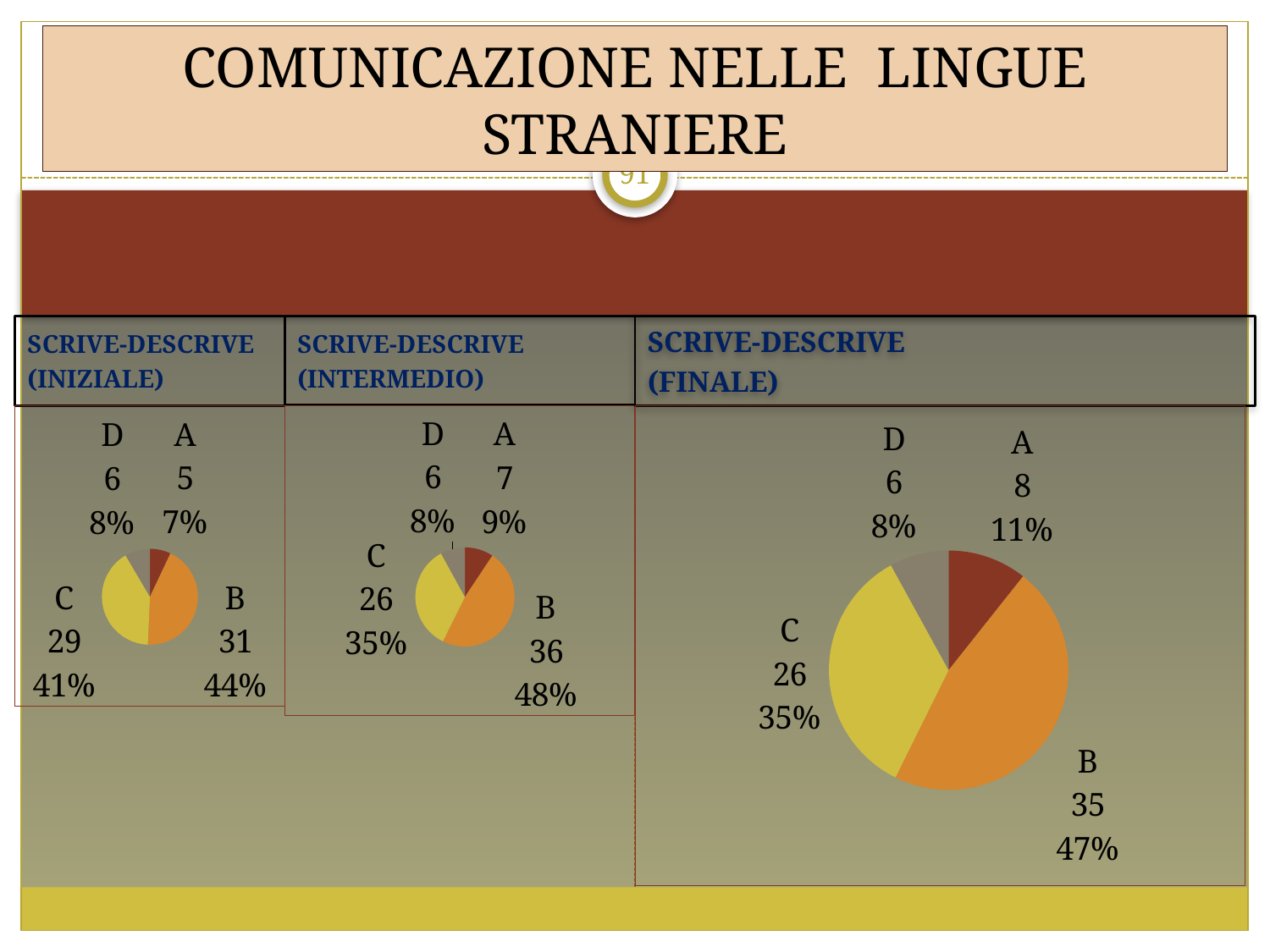
What kind of chart is the SCRIVE-DESCRIVE (INIZIALE) chart? Pie chart In the SCRIVE-DESCRIVE (INTERMEDIO) chart, what is the value for category B? 36 In the SCRIVE-DESCRIVE (FINALE) chart, what percentage share does category B have? 47% In the SCRIVE-DESCRIVE (INTERMEDIO) chart, what percentage share does category A have? 9% In the SCRIVE-DESCRIVE (INTERMEDIO) chart, which category has the highest value? B In the SCRIVE-DESCRIVE (FINALE) chart, what is the difference between the values for B and C? 9 In the SCRIVE-DESCRIVE (INIZIALE) chart, what percentage share does category C have? 41% How many categories does the SCRIVE-DESCRIVE (FINALE) chart show? 4 In the SCRIVE-DESCRIVE (INIZIALE) chart, what is the value for category B? 31 In the SCRIVE-DESCRIVE (FINALE) chart, which is larger, the value for C or the value for D? C In the SCRIVE-DESCRIVE (INIZIALE) chart, which category has the lowest value? A In the SCRIVE-DESCRIVE (FINALE) chart, what is the value for category A? 8